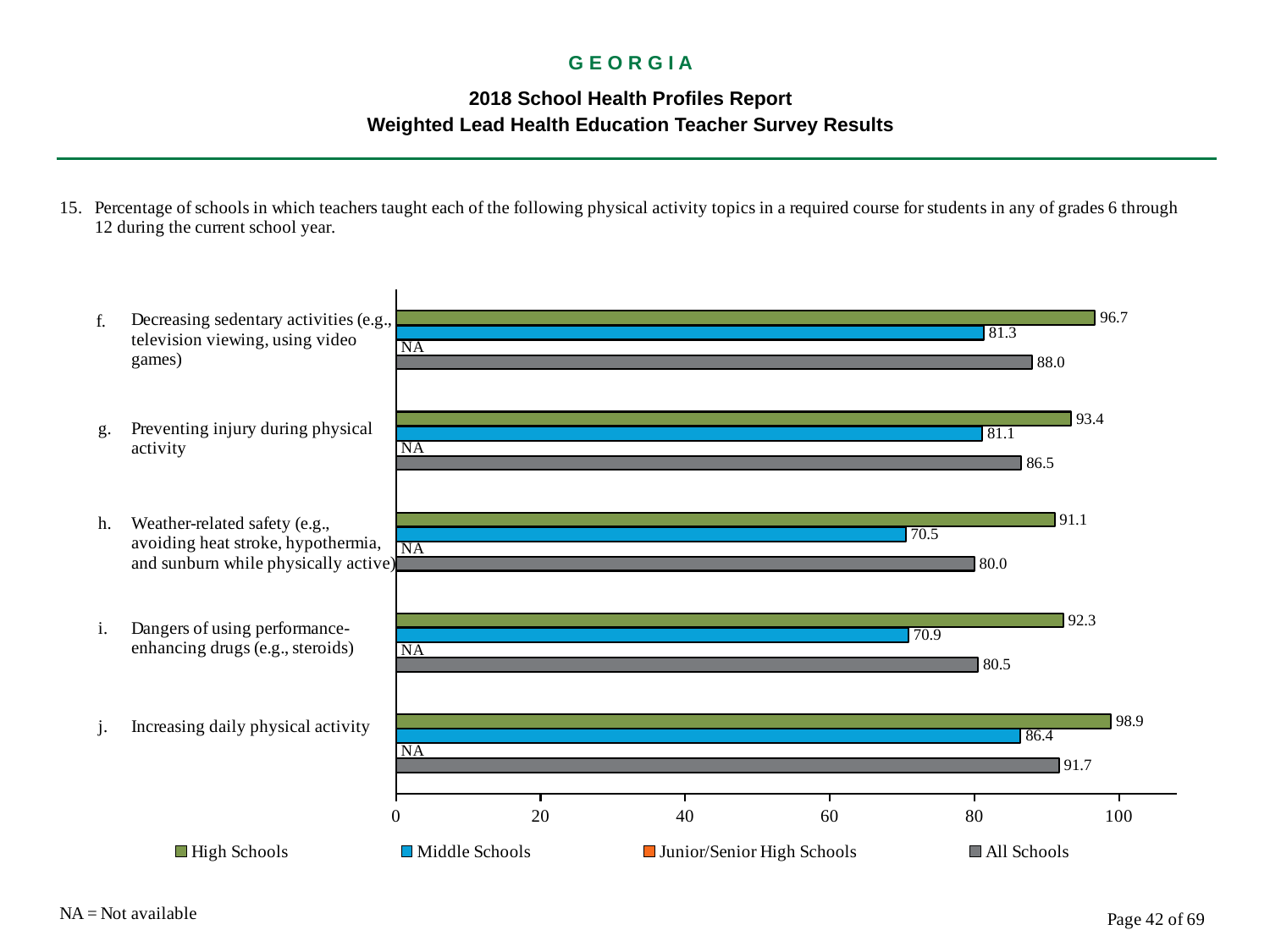
What is the High Schools value for 'Increasing daily physical activity'? 98.9 Which topic has the highest High Schools value? Increasing daily physical activity How many series does the legend list? 4 What is the difference between the High Schools and Middle Schools values for 'Decreasing sedentary activities'? 15.4 What is the All Schools value for 'Preventing injury during physical activity'? 86.5 What is the Junior/Senior High Schools value for 'Dangers of using performance-enhancing drugs'? NA What is the Middle Schools value for 'Weather-related safety'? 70.5 What kind of chart is shown on the slide? bar chart Which topic has the lowest Middle Schools value? Weather-related safety Which is larger: the All Schools value for 'Weather-related safety' or for 'Dangers of using performance-enhancing drugs'? Dangers of using performance-enhancing drugs Is the Middle Schools value for 'Increasing daily physical activity' greater or less than 80? greater How many physical activity topics are shown on the chart? 5